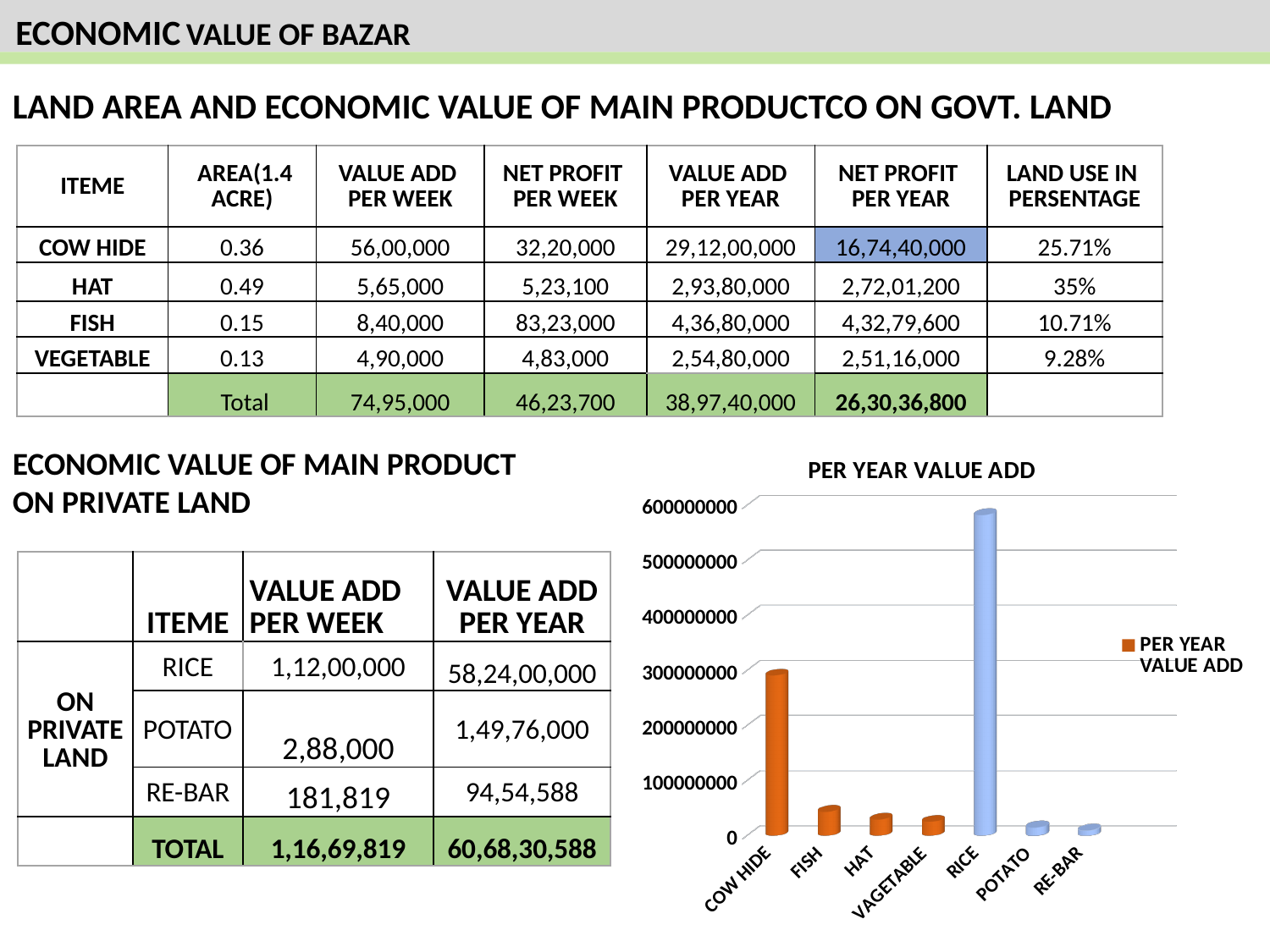
How many categories are shown on the x axis of the chart? 7 Is the value for COW HIDE in the chart greater or less than 200000000? greater Is the value for RICE in the chart greater or less than 500000000? greater In the chart, which is larger, the value for RICE or the value for COW HIDE? RICE What is the legend entry shown on the chart? PER YEAR VALUE ADD What is the title of the chart on the slide? PER YEAR VALUE ADD In the chart, which is larger, the value for COW HIDE or the value for FISH? COW HIDE How many series does the chart's legend list? 1 Is the value for FISH in the chart greater or less than 100000000? less What kind of chart is shown on the slide? bar chart Which category has the highest bar in the chart? RICE